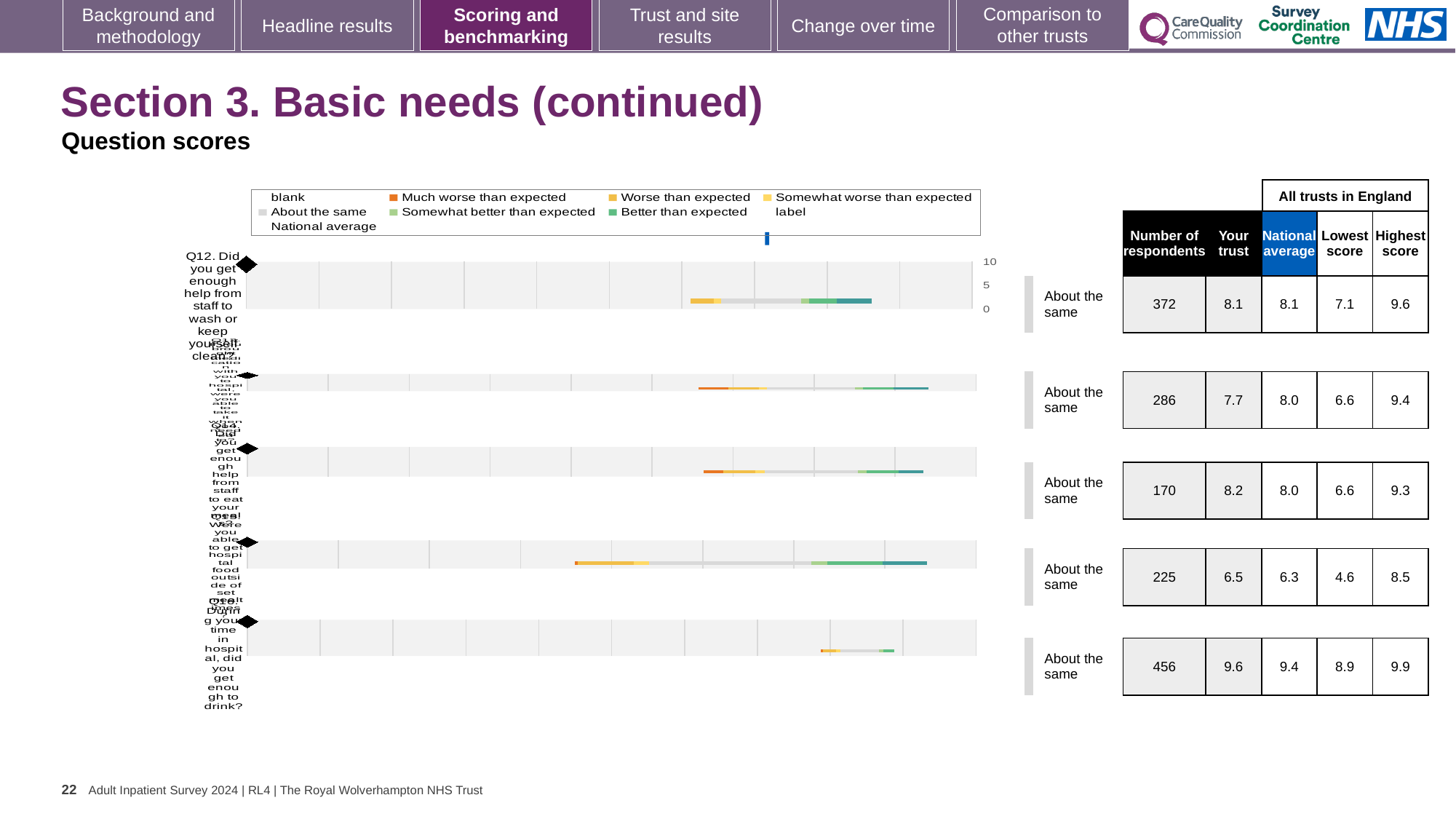
What is the subtitle shown above the chart? Question scores How many questions (rows) are plotted in the chart? 5 What is the difference between the highest score and the lowest score for Q15? 3.9 What is the number of respondents for Q12 (help from staff to wash or keep yourself clean)? 372 What benchmark category is shown for Q12? About the same Which question has the highest 'Your trust' score? Q16 For Q14, is the 'Your trust' score or the national average higher? Your trust What is the 'Your trust' score for Q16 (did you get enough to drink)? 9.6 What kind of chart is used to show the question scores on this slide? bar chart Which question has the lowest 'Your trust' score? Q15 What is the national average score for Q15 (hospital food outside of set meal times)? 6.3 In the legend, what colour represents 'Much worse than expected'? orange